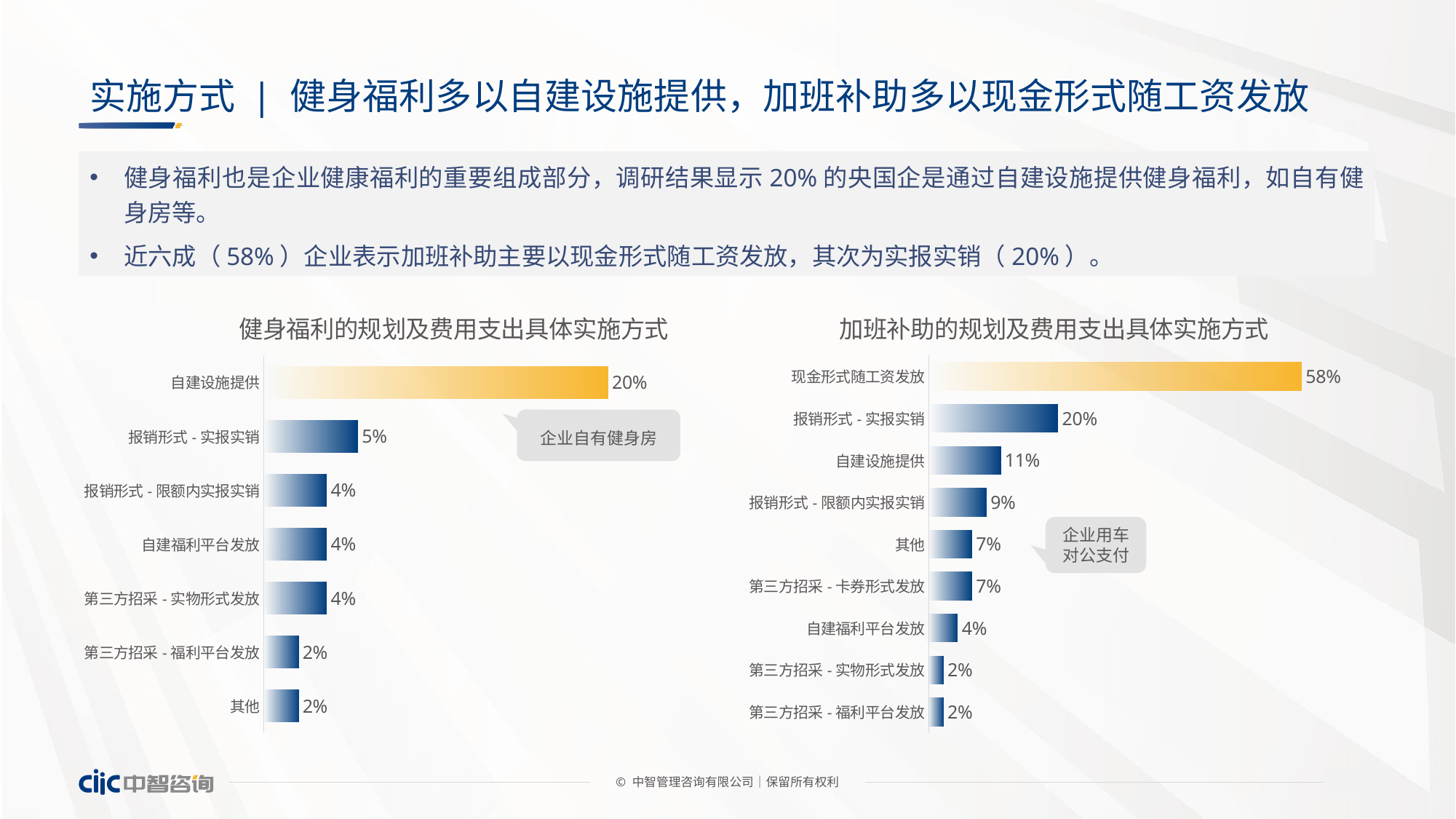
In the chart titled 健身福利的规划及费用支出具体实施方式, how many categories are shown? 7 In the chart titled 加班补助的规划及费用支出具体实施方式, what is the value for 现金形式随工资发放? 58% In the chart titled 健身福利的规划及费用支出具体实施方式, what is the value for 自建设施提供? 20% In the chart titled 加班补助的规划及费用支出具体实施方式, what is the value for 报销形式 - 限额内实报实销? 9% What type of chart is the chart titled 加班补助的规划及费用支出具体实施方式? Bar chart In the chart titled 健身福利的规划及费用支出具体实施方式, which category has the highest value? 自建设施提供 In the chart titled 健身福利的规划及费用支出具体实施方式, what is the difference between 自建设施提供 and 报销形式 - 实报实销? 15% In the chart titled 健身福利的规划及费用支出具体实施方式, what is the value for 报销形式 - 实报实销? 5% In the chart titled 加班补助的规划及费用支出具体实施方式, what is the difference between 现金形式随工资发放 and 报销形式 - 实报实销? 38% In the chart titled 加班补助的规划及费用支出具体实施方式, what is the value for 自建设施提供? 11% In the chart titled 加班补助的规划及费用支出具体实施方式, how many categories are shown? 9 In the chart titled 加班补助的规划及费用支出具体实施方式, which is larger, 报销形式 - 实报实销 or 自建设施提供? 报销形式 - 实报实销